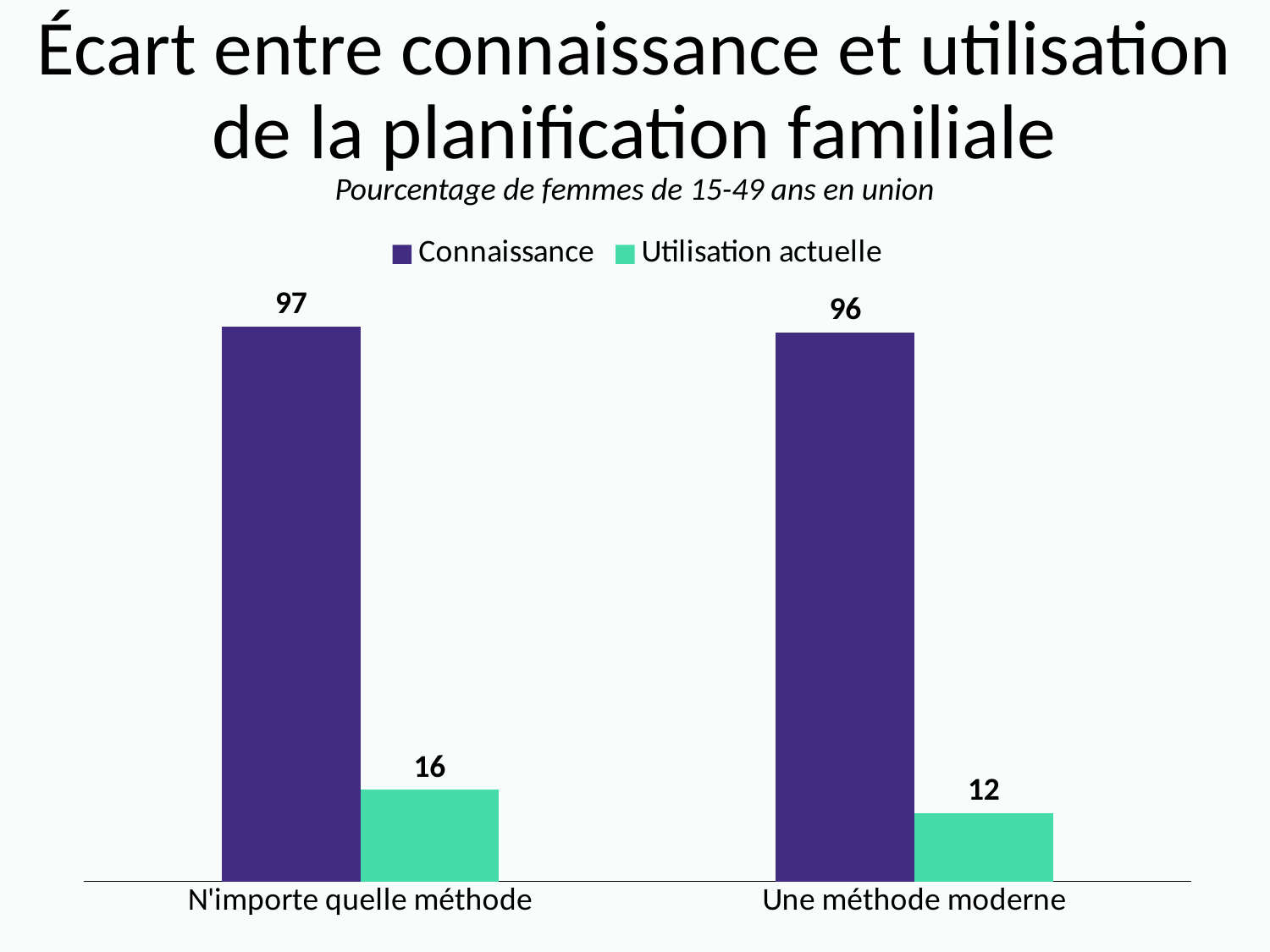
What is the Utilisation actuelle value for N'importe quelle méthode? 16 What is the Connaissance value for Une méthode moderne? 96 Which category has the highest Utilisation actuelle value? N'importe quelle méthode How many categories are shown on the x axis? 2 What is the difference between Connaissance and Utilisation actuelle for Une méthode moderne? 84 Which is larger for Une méthode moderne: Connaissance or Utilisation actuelle? Connaissance How many series does the legend list? 2 What kind of chart is shown on the slide? Bar chart What is the Connaissance value for N'importe quelle méthode? 97 Which category has the lowest Utilisation actuelle value? Une méthode moderne What is the difference between Connaissance and Utilisation actuelle for N'importe quelle méthode? 81 What is the Utilisation actuelle value for Une méthode moderne? 12